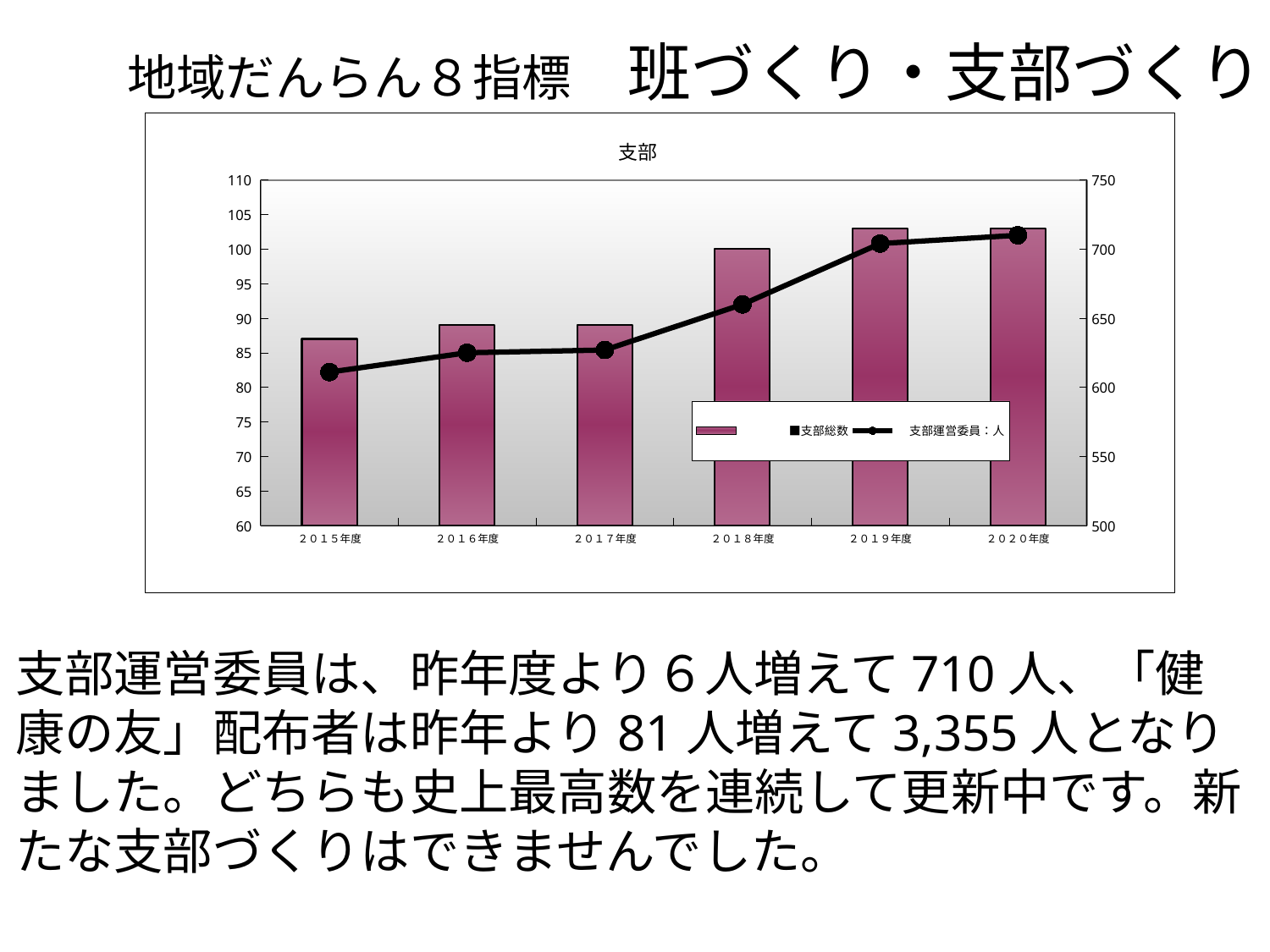
Does the 支部運営委員：人 line rise or fall from 2015年度 to 2020年度? rises Which is larger, the 支部総数 bar for 2017年度 or for 2018年度? 2018年度 Is the 支部運営委員：人 value for 2020年度 greater or less than 700? greater How many fiscal-year categories are shown on the x axis? 6 What are the two series named in the legend? 支部総数 and 支部運営委員：人 How many series does the chart legend list? 2 Which year has the lowest bar for 支部総数? 2015年度 What kind of chart is this? Combined bar and line chart Is the 支部総数 bar for 2019年度 greater or less than 100? greater Is the 支部総数 bar for 2015年度 greater or less than 90? less What is the title of the chart? 支部